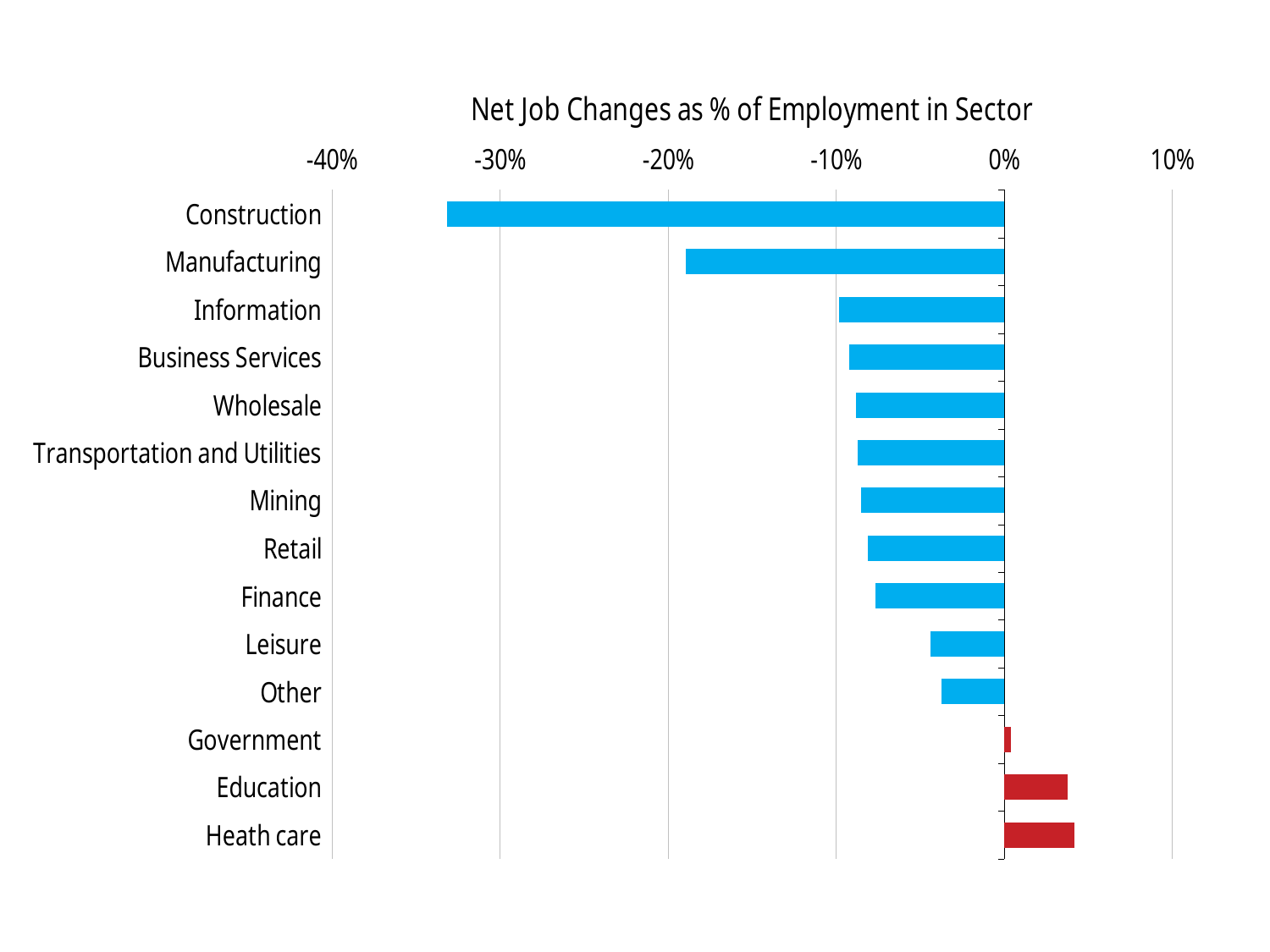
How many sectors are shown with red bars? 3 Which has the larger net job change, Construction or Manufacturing? Manufacturing Is the value for Construction greater or less than -30%? less Is the value for Leisure greater or less than -10%? greater What type of chart is shown on the slide? bar chart How many sectors are shown in the chart? 14 Which sector has the highest net job change? Heath care Which sector has the lowest (most negative) net job change? Construction What is the title of the chart? Net Job Changes as % of Employment in Sector Is the value for Finance greater or less than -10%? greater Which has the larger net job change, Leisure or Retail? Leisure